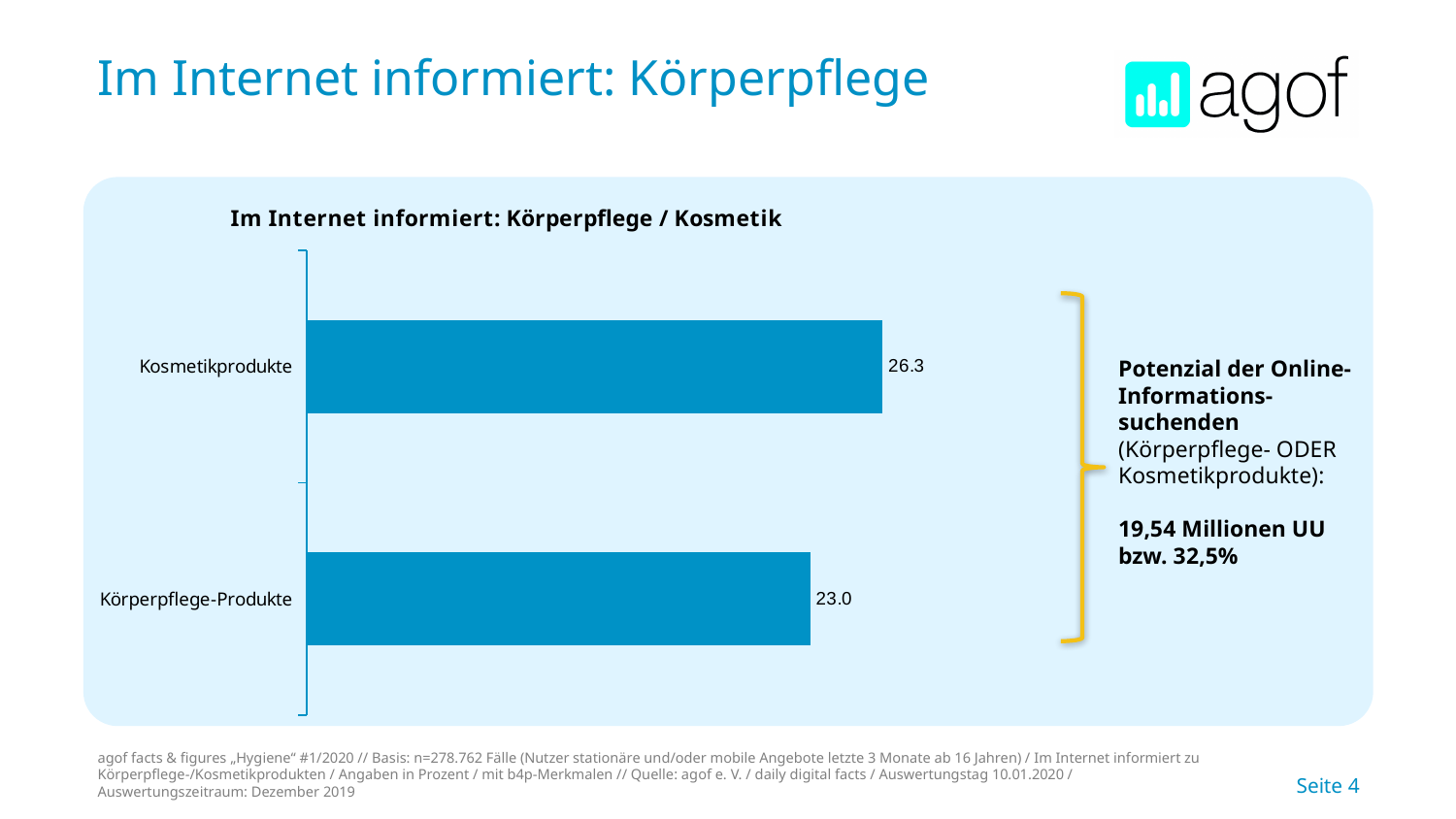
What is the value for Körperpflege-Produkte? 23.0 What is the difference between the values for Kosmetikprodukte and Körperpflege-Produkte? 3.3 What is the value for Kosmetikprodukte? 26.3 Which is larger, the value for Kosmetikprodukte or for Körperpflege-Produkte? Kosmetikprodukte Which category has the lowest value? Körperpflege-Produkte What kind of chart is shown on the slide? Bar chart Which category has the highest value? Kosmetikprodukte How many categories are shown in the chart? 2 What colour are the bars in the chart? Blue What is the title of the chart? Im Internet informiert: Körperpflege / Kosmetik